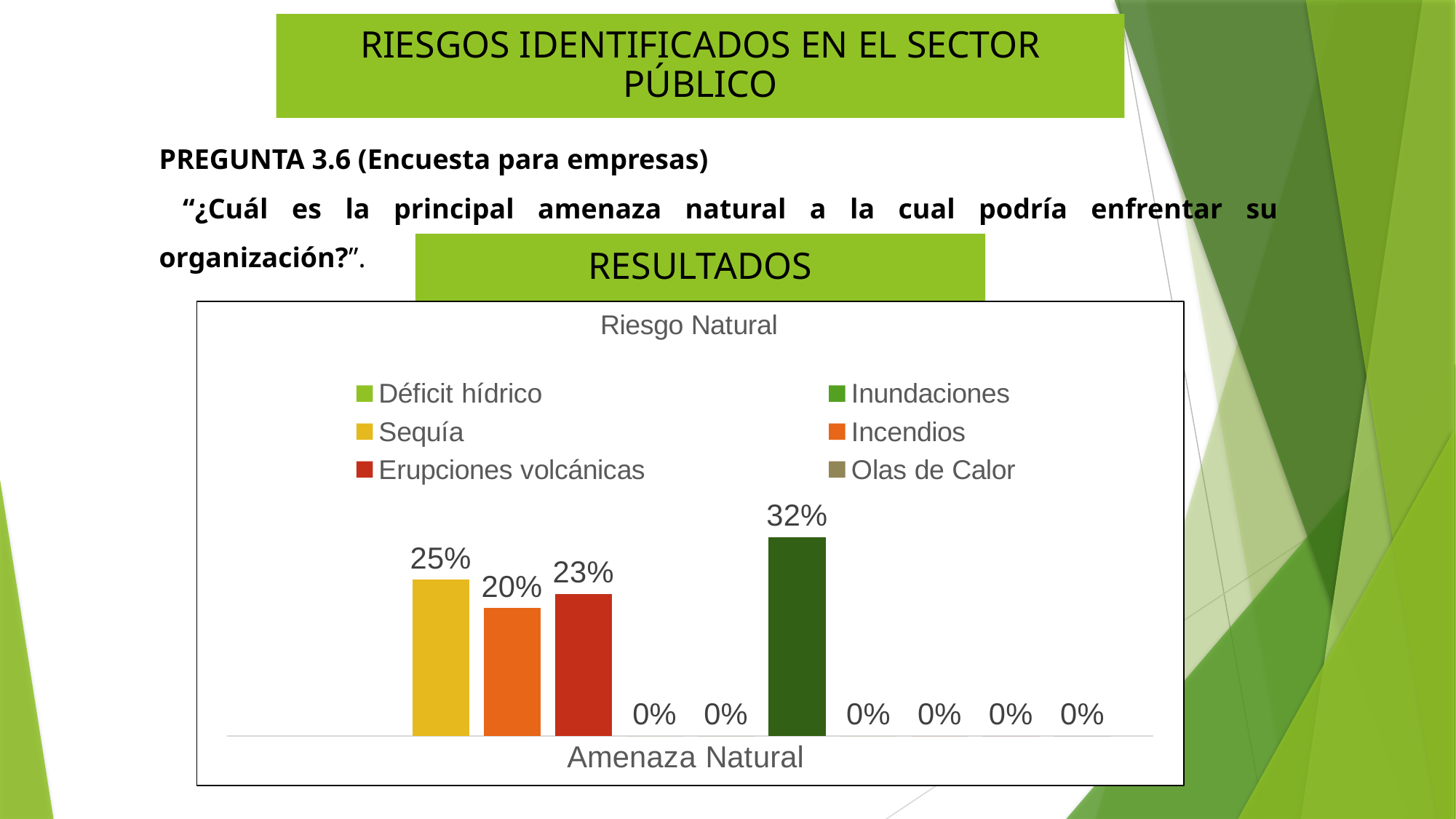
How many entries does the legend of the Riesgo Natural chart list? 6 What is the value for Erupciones volcánicas in the Riesgo Natural chart? 23% What is the title of the chart on the slide? Riesgo Natural What is the value for Sequía in the Riesgo Natural chart? 25% Which is larger, the value for Sequía or the value for Erupciones volcánicas? Sequía What is the value for Incendios in the Riesgo Natural chart? 20% What is the difference between the values for Sequía and Incendios? 5 percentage points What kind of chart is shown on the slide? Bar chart